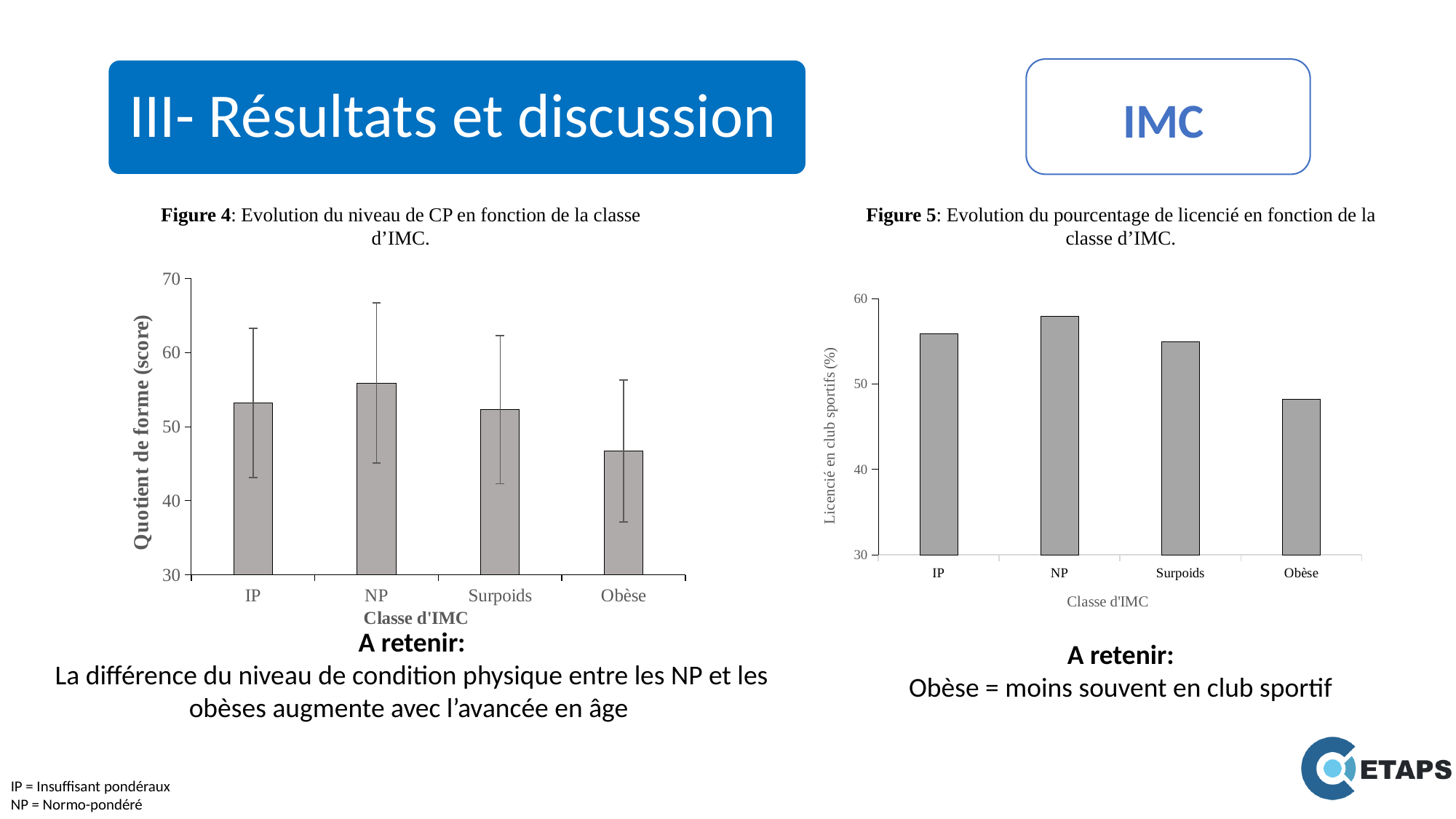
In Figure 4, is the value for NP greater or less than 50? greater In Figure 4, is the value for Obèse greater or less than 50? less In Figure 5, which IMC class has the lowest percentage of licenciés en club sportif? Obèse In Figure 4, what is the label of the y axis? Quotient de forme (score) In Figure 4, which is larger, the value for NP or the value for Obèse? NP In Figure 4, how many IMC classes are plotted on the x axis? 4 In Figure 5, which IMC class has the highest percentage of licenciés en club sportif? NP In Figure 4, which IMC class has the highest Quotient de forme? NP In Figure 4, what kind of chart is shown? bar chart In Figure 4, which IMC class has the lowest Quotient de forme? Obèse In Figure 5, is the value for Obèse greater or less than 50? less In Figure 5, which is larger, the value for IP or the value for Obèse? IP